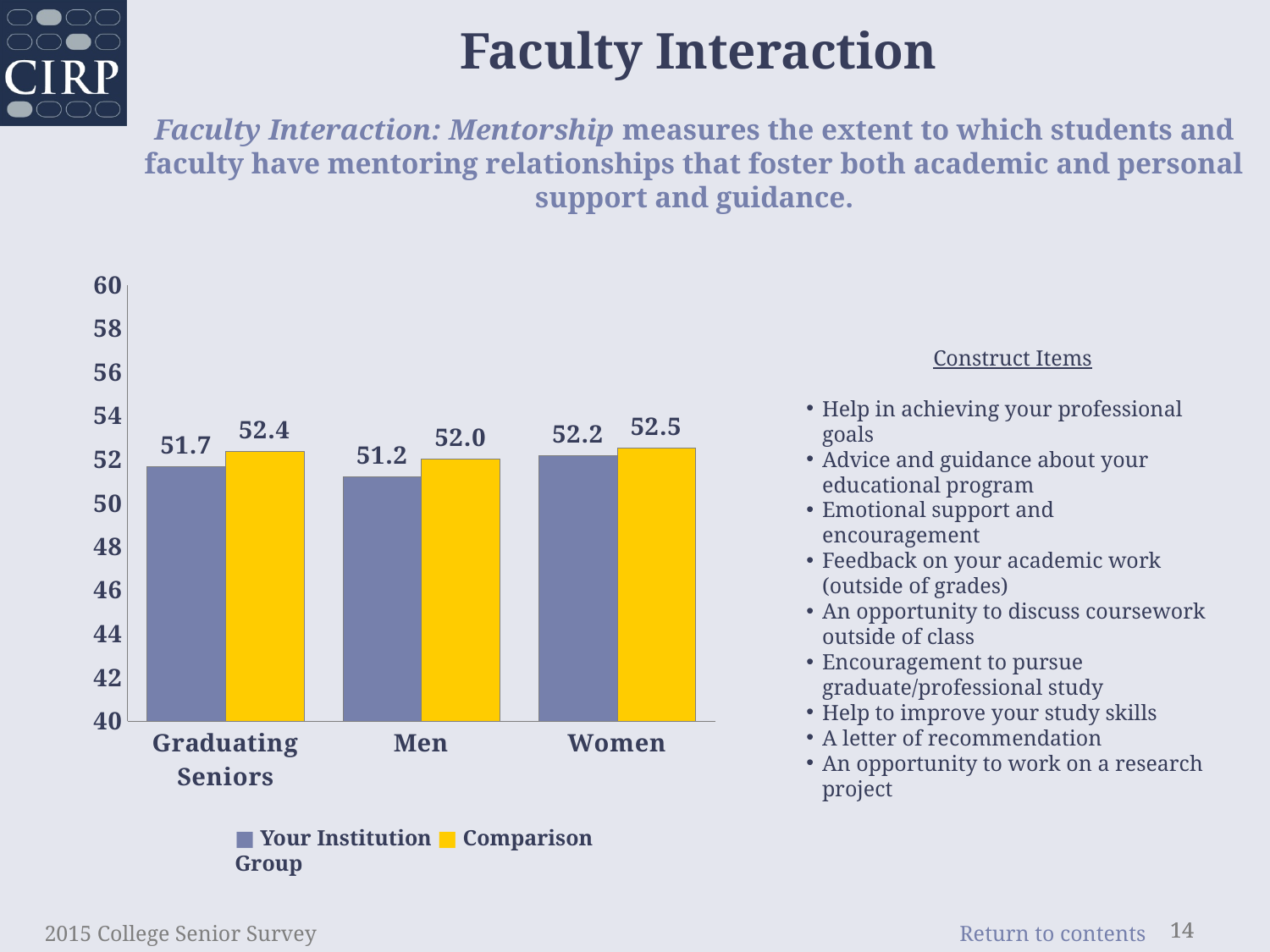
How many categories are shown on the x axis? 3 What is the value for Your Institution for Graduating Seniors? 51.7 What is the value for Comparison Group for Women? 52.5 What kind of chart is shown on the slide? Bar chart Which category has the lowest value for Your Institution? Men What colour are the Comparison Group bars? Yellow Which category has the highest value for Comparison Group? Women What is the difference between the Comparison Group and Your Institution values for Men? 0.8 What is the value for Comparison Group for Men? 52.0 How many series does the legend list? 2 Which is larger for Graduating Seniors: Your Institution or Comparison Group? Comparison Group What is the value for Your Institution for Women? 52.2